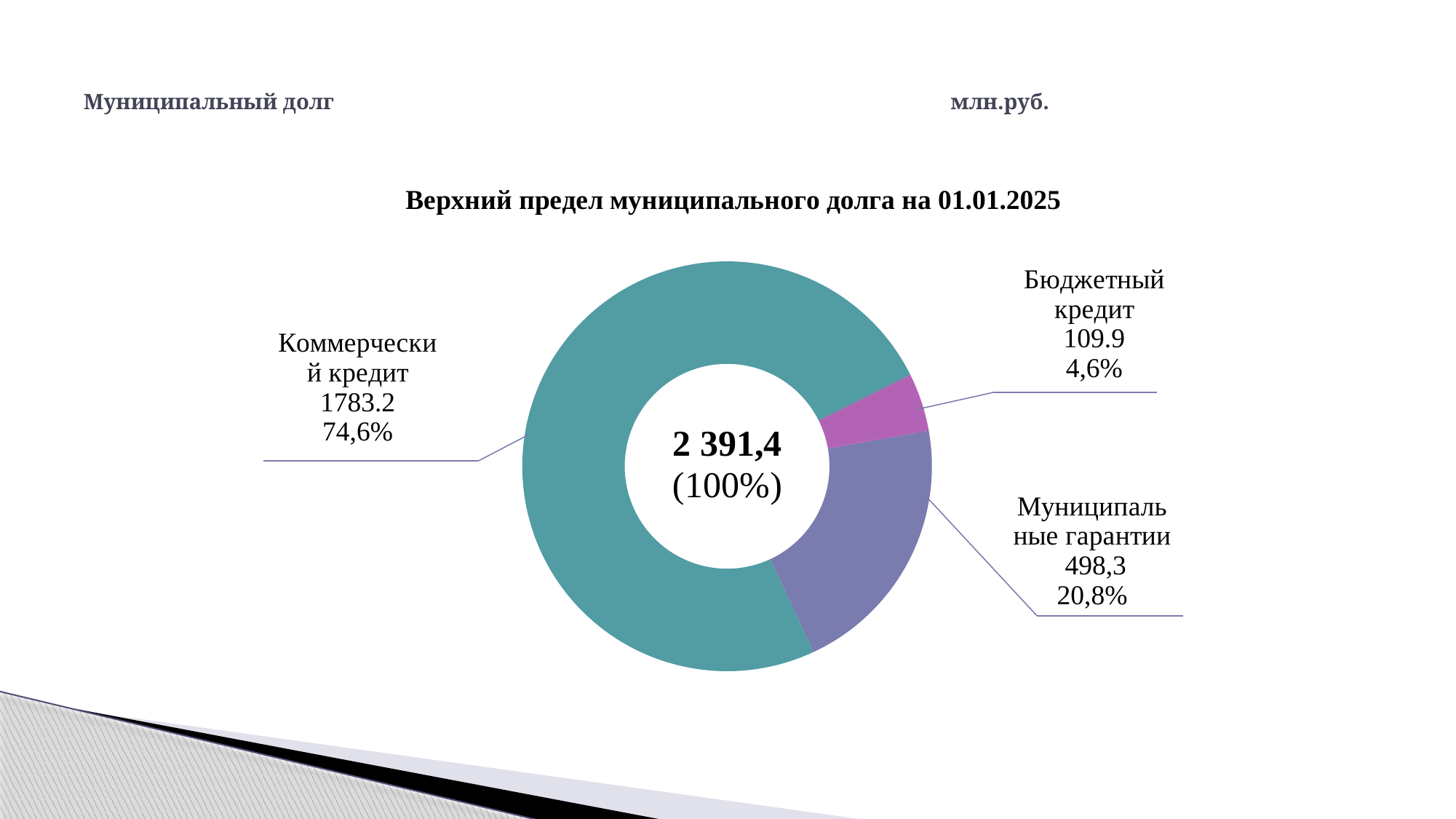
What is the value for Муниципальные гарантии? 498,3 What is the total value shown in the centre of the chart? 2 391,4 How many categories does the chart show? 3 By how many percentage points does the share of Коммерческий кредит exceed the share of Муниципальные гарантии? 53,8% What is the title of the chart? Верхний предел муниципального долга на 01.01.2025 Which category has the largest share? Коммерческий кредит What share of the total does Муниципальные гарантии represent? 20,8% What kind of chart is shown on the slide? Pie chart (donut) What is the value for Коммерческий кредит? 1783.2 What share of the total does Бюджетный кредит represent? 4,6% What is the value for Бюджетный кредит? 109.9 Which category has the smallest share? Бюджетный кредит